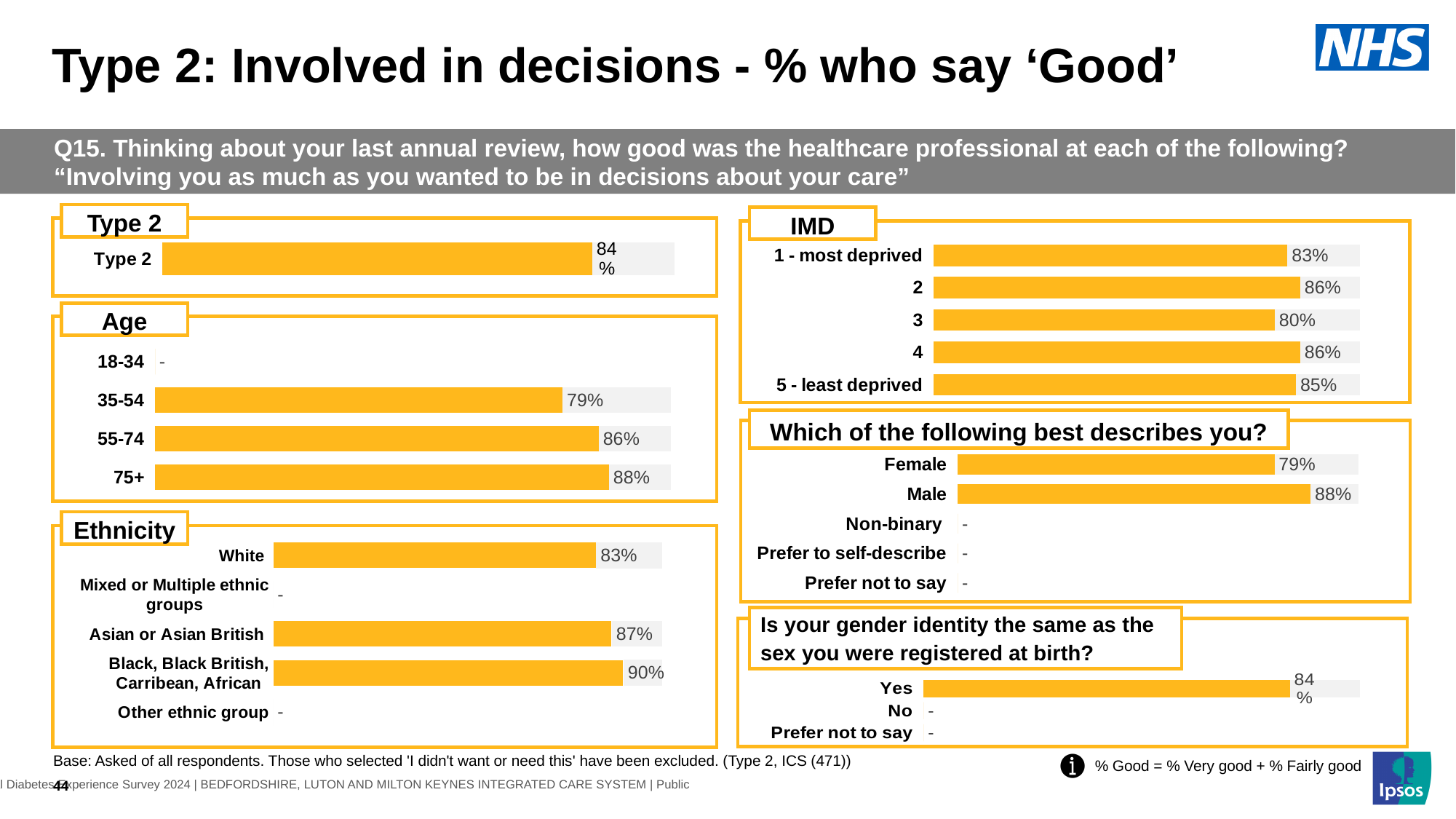
In the Type 2 chart, what is the value for Type 2? 84% In the Ethnicity chart, what is the value for Asian or Asian British? 87% What type of chart is used in the Age section? Bar chart In the Ethnicity chart, which ethnic group has the highest percentage? Black, Black British, Carribean, African In the Age chart, what is the value for 75+? 88% In the Age chart, what is the difference between the values for 75+ and 35-54? 9 percentage points In the 'Which of the following best describes you?' chart, which is larger, Female or Male? Male In the Age chart, which age group with a plotted value has the lowest percentage? 35-54 In the IMD chart, which IMD group has the lowest percentage? 3 In the 'Which of the following best describes you?' chart, what is the difference between Male and Female? 9 percentage points In the IMD chart, what is the value for 3? 80% In the IMD chart, how many categories are shown? 5